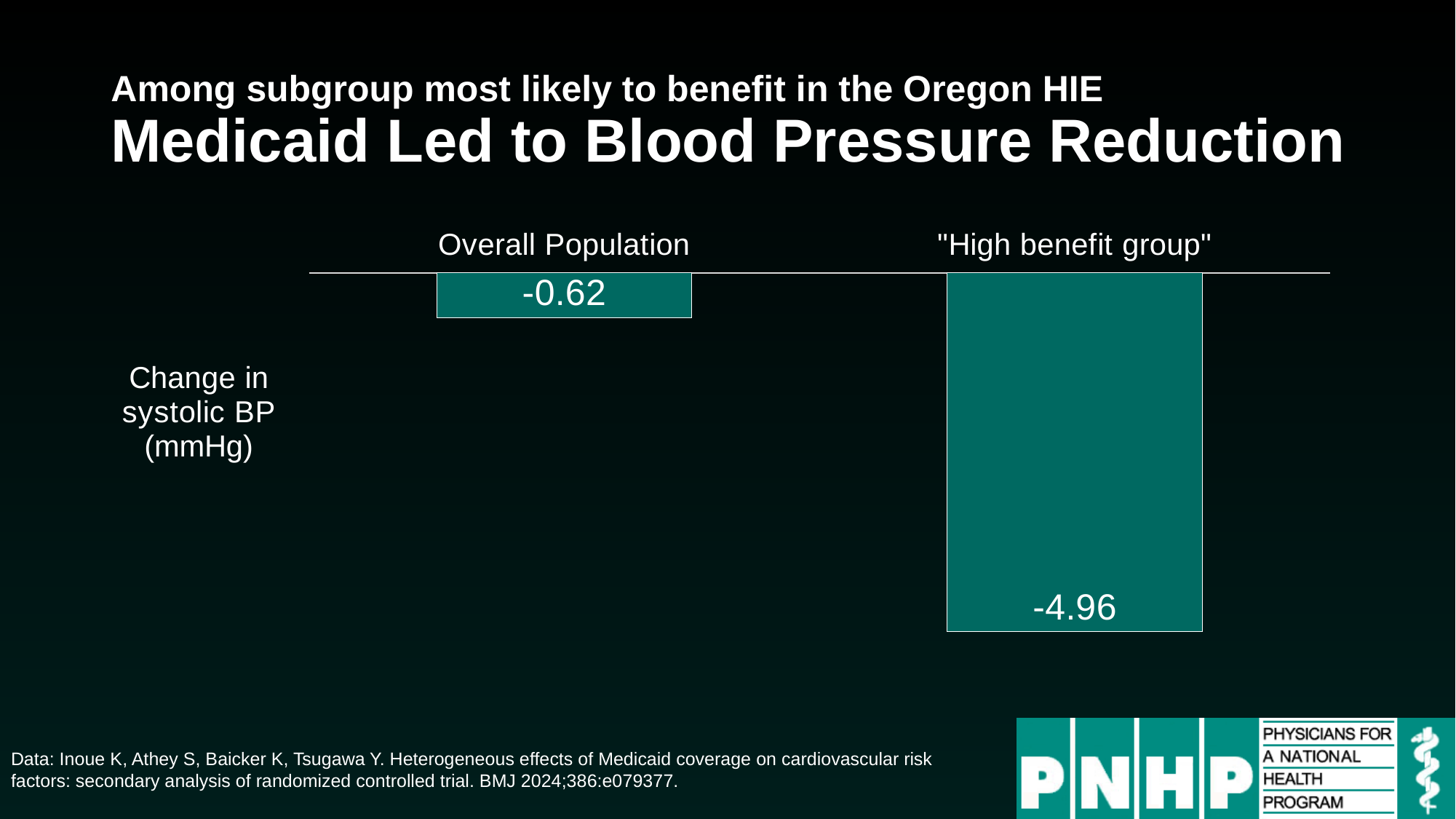
What is the main title of the slide? Medicaid Led to Blood Pressure Reduction What is the change in systolic BP for the "High benefit group"? -4.96 What is the difference between the change in systolic BP for the "High benefit group" and the Overall Population? 4.34 How many groups are plotted in the chart? 2 Which group shows the smaller reduction in systolic BP? Overall Population What kind of chart is shown on the slide? Bar chart Which group shows the larger reduction in systolic BP? "High benefit group" Is the reduction in systolic BP larger for the Overall Population or the "High benefit group"? "High benefit group" What is the change in systolic BP for the Overall Population? -0.62 Are the values for both groups positive or negative? Negative What unit is the change in systolic BP measured in? mmHg